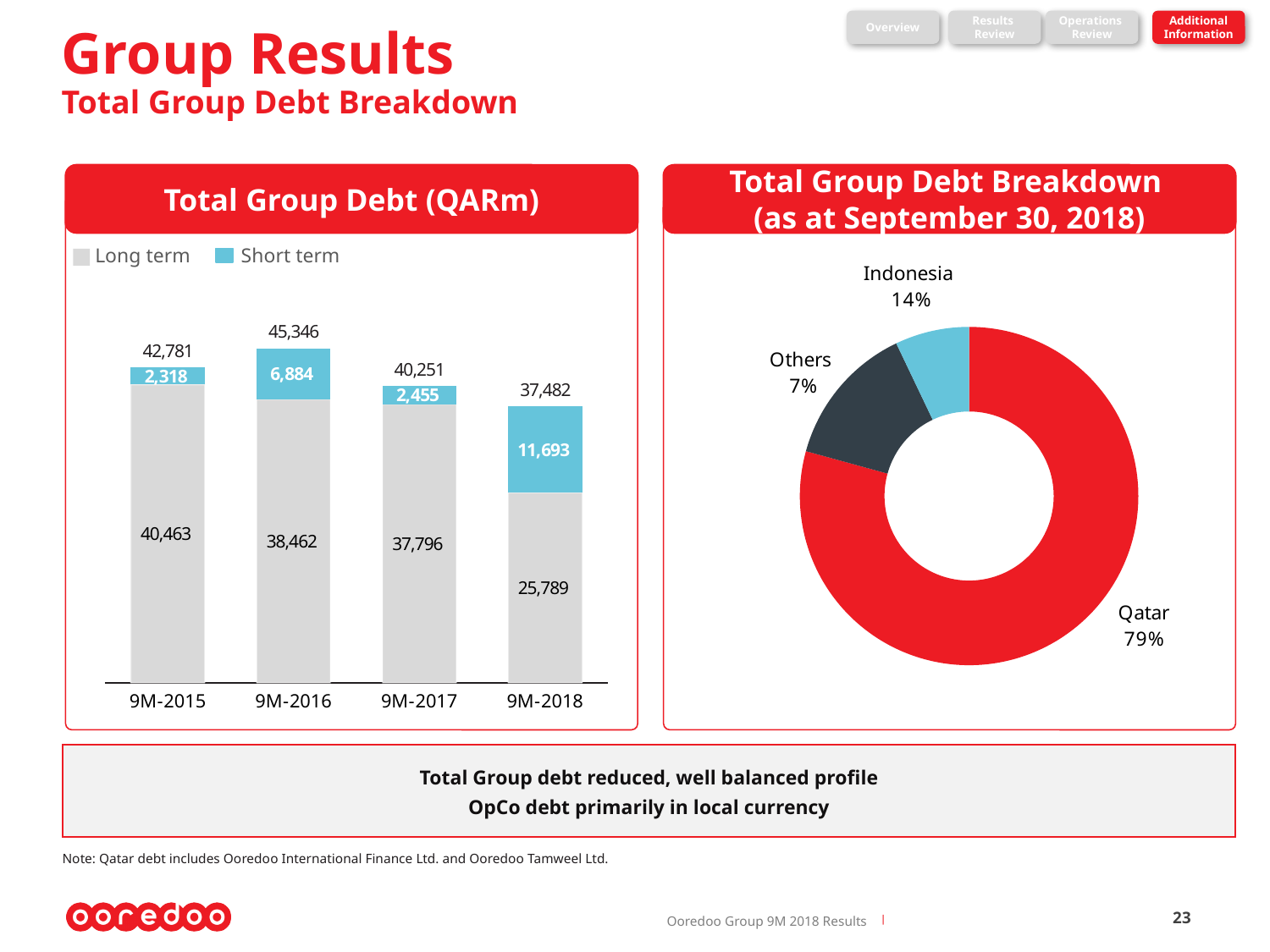
In the Total Group Debt (QARm) chart, which period has the lowest Long term value? 9M-2018 In the Total Group Debt (QARm) chart, what is the total debt for 9M-2017? 40,251 In the Total Group Debt (QARm) chart, what is the difference between the Short term values for 9M-2018 and 9M-2017? 9,238 In the Total Group Debt (QARm) chart, how many periods are shown on the x axis? 4 In the Total Group Debt (QARm) chart, what is the Short term value for 9M-2018? 11,693 In the Total Group Debt Breakdown (as at September 30, 2018) chart, which segment is the largest? Qatar In the Total Group Debt (QARm) chart, how many series does the legend list? 2 What kind of chart is the Total Group Debt Breakdown (as at September 30, 2018) chart? Pie chart (doughnut) In the Total Group Debt (QARm) chart, what is the Long term value for 9M-2016? 38,462 In the Total Group Debt (QARm) chart, which period has the highest total debt? 9M-2016 In the Total Group Debt (QARm) chart, is the Long term value larger for 9M-2015 or 9M-2017? 9M-2015 In the Total Group Debt Breakdown (as at September 30, 2018) chart, what share does Indonesia have? 14%